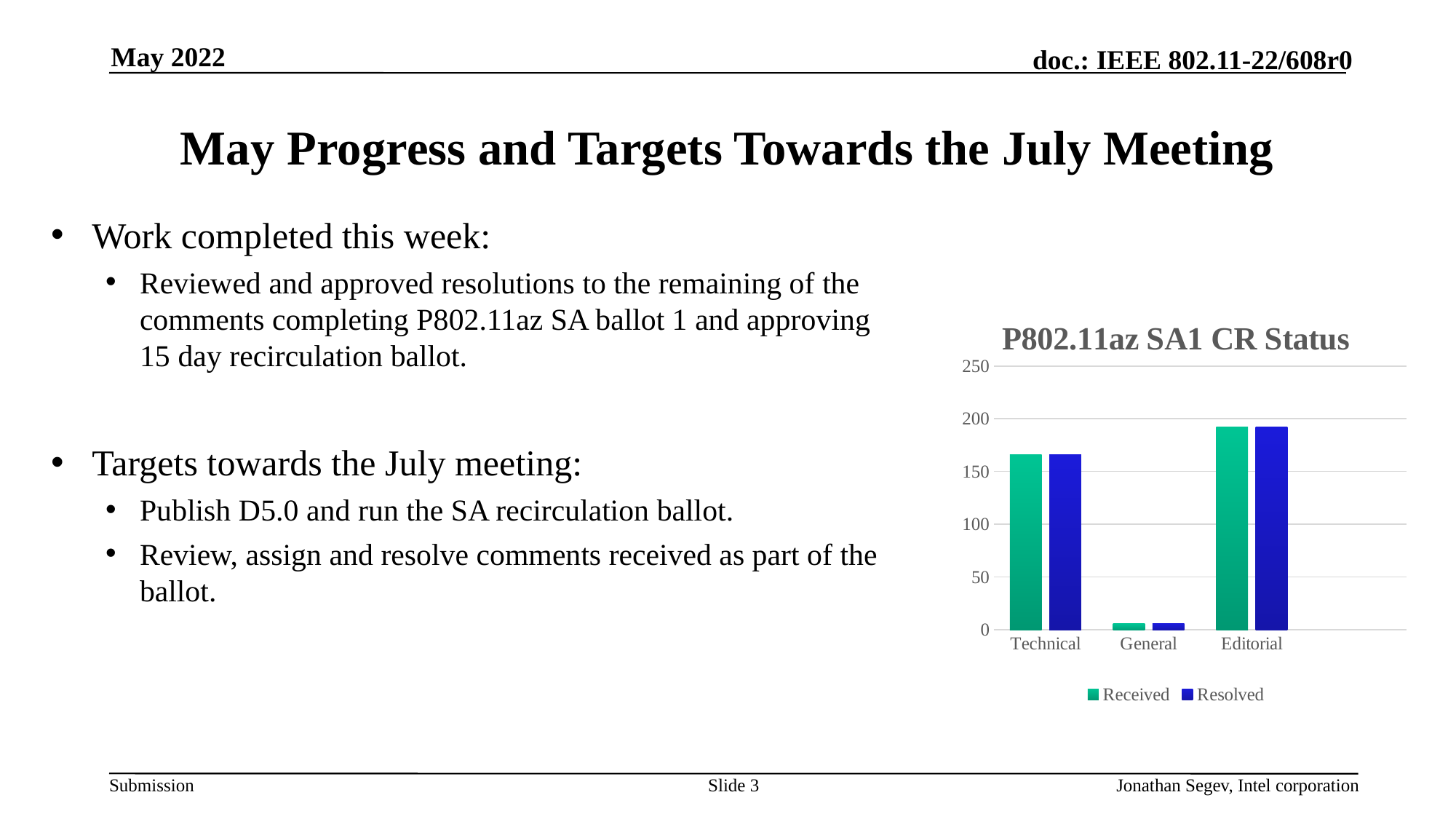
Is the Resolved value for Editorial greater or less than 200? less Is the Received value for Technical greater or less than 150? greater Which is larger, the Received value for Editorial or the Received value for Technical? Editorial How many series does the chart's legend list? 2 Which category has the highest Received value? Editorial Is the Resolved value for Technical greater or less than 200? less How many categories are shown on the x axis of the chart? 3 What is the title of the chart on the slide? P802.11az SA1 CR Status Which category has the lowest Resolved value? General What kind of chart is shown on the slide? bar chart Which series are listed in the chart's legend? Received and Resolved